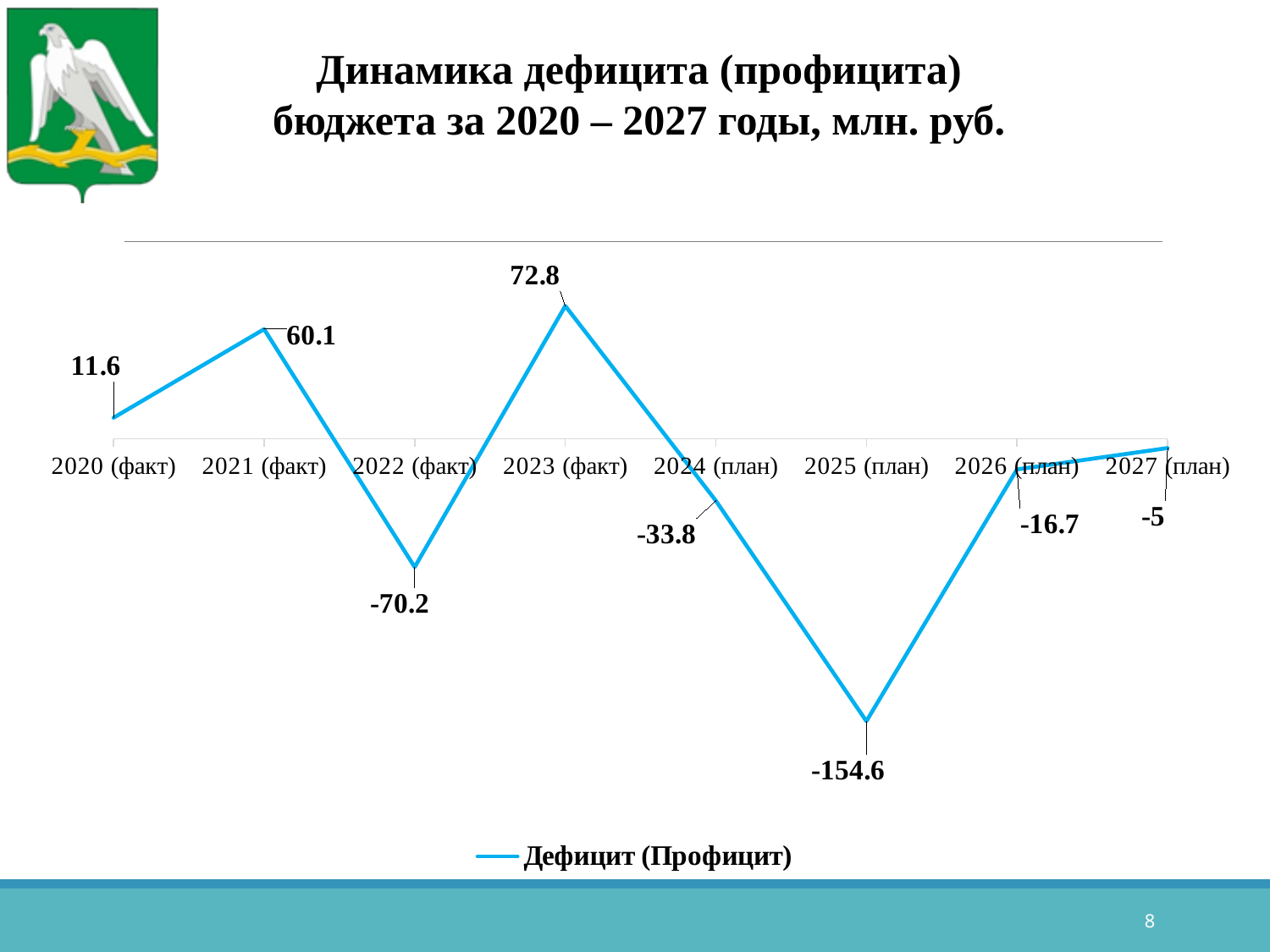
What is the name of the series shown in the legend? Дефицит (Профицит) Which year has the lowest value? 2025 (план) How many series does the legend list? 1 What kind of chart is shown on the slide? line chart Which is larger, the value for 2022 (факт) or the value for 2024 (план)? 2024 (план) Which year has the highest value? 2023 (факт) What is the value for 2020 (факт)? 11.6 How many years are plotted on the chart? 8 What is the difference between the values for 2023 (факт) and 2021 (факт)? 12.7 What is the value for 2027 (план)? -5 What is the value for 2025 (план)? -154.6 What is the value for 2023 (факт)? 72.8